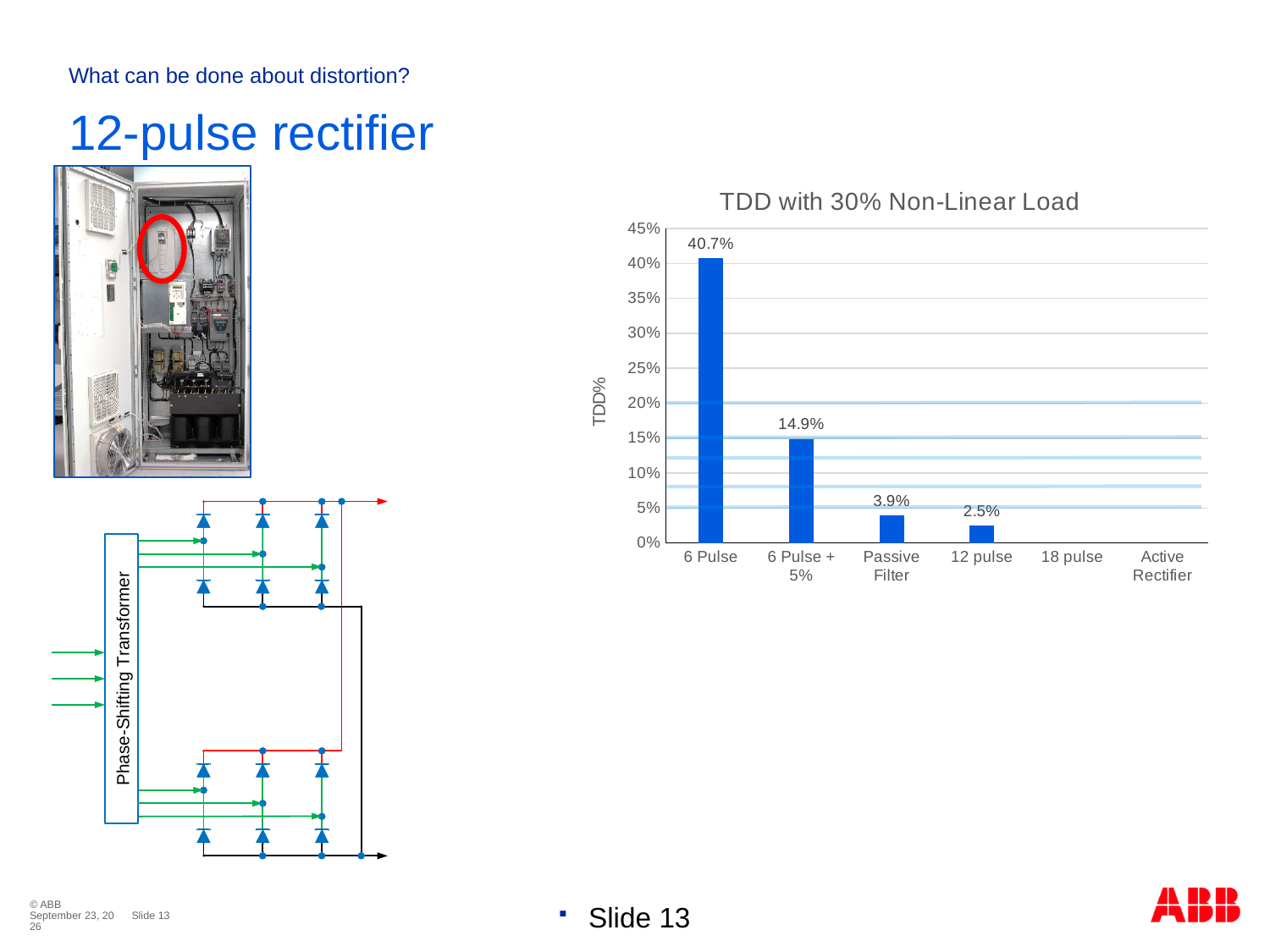
Which category has the tallest bar in the chart? 6 Pulse Which has a higher TDD value, Passive Filter or 6 Pulse + 5%? 6 Pulse + 5% What is the difference between the TDD values for 6 Pulse and 6 Pulse + 5%? 25.8% What is the TDD value for Passive Filter? 3.9% What is the TDD value for 6 Pulse in the chart? 40.7% What is the TDD value for 6 Pulse + 5%? 14.9% What kind of chart is shown on the slide? Bar chart Which of the labelled bars has the lowest TDD value? 12 pulse What is the TDD value for 12 pulse? 2.5% What is the title of the chart? TDD with 30% Non-Linear Load How many categories are shown on the x axis of the chart? 6 What is the difference between the TDD values for Passive Filter and 12 pulse? 1.4%